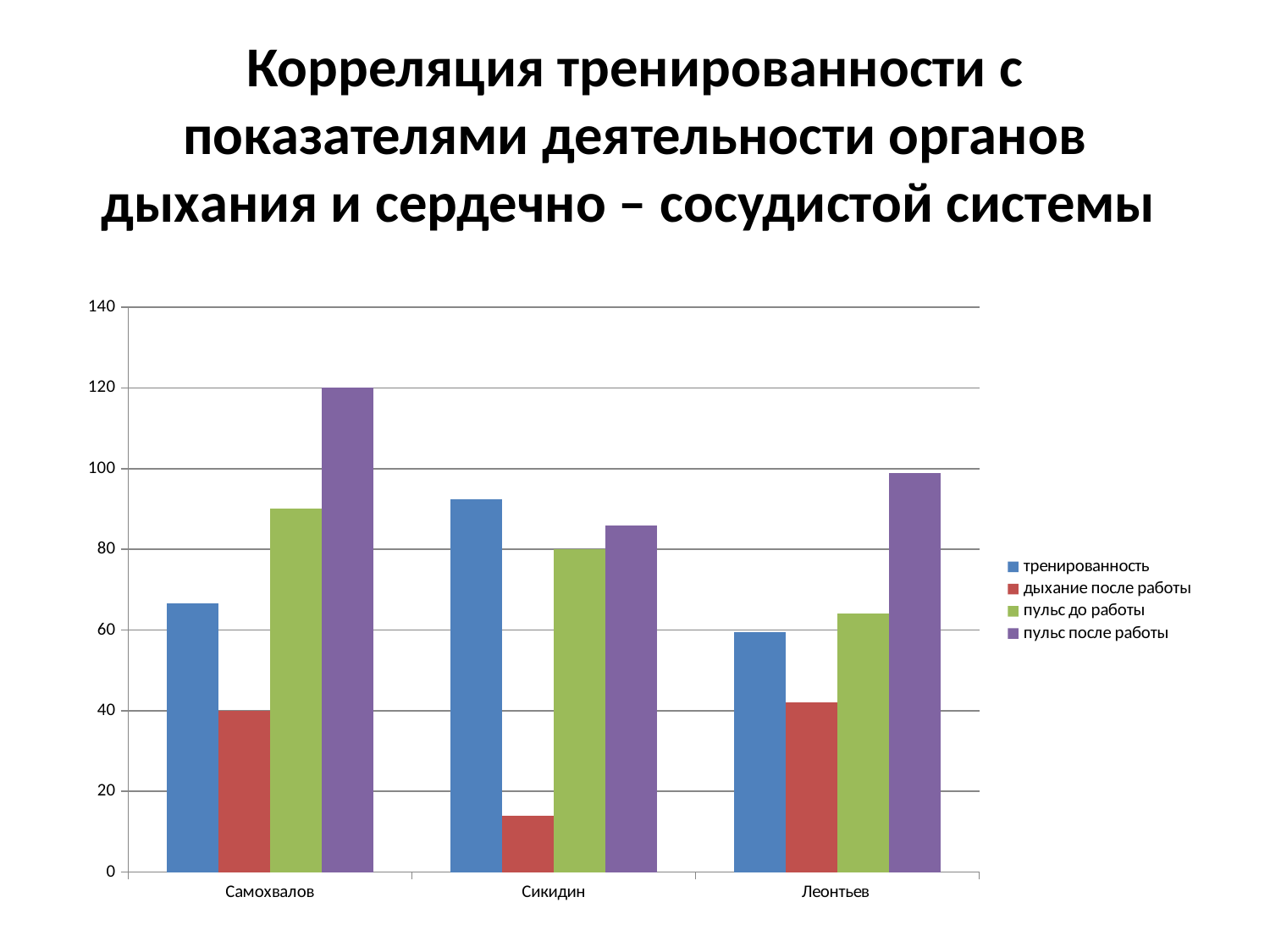
Which is larger for Сикидин: тренированность or пульс после работы? тренированность What is the value of дыхание после работы for Самохвалов? 40 What is the value of пульс после работы for Самохвалов? 120 How many series does the legend list? 4 What kind of chart is shown on the slide? bar chart Which person has the highest value for тренированность? Сикидин Which person has the lowest value for дыхание после работы? Сикидин Which person has the highest value for пульс после работы? Самохвалов What is the value of пульс до работы for Сикидин? 80 How many categories (people) are shown on the x axis? 3